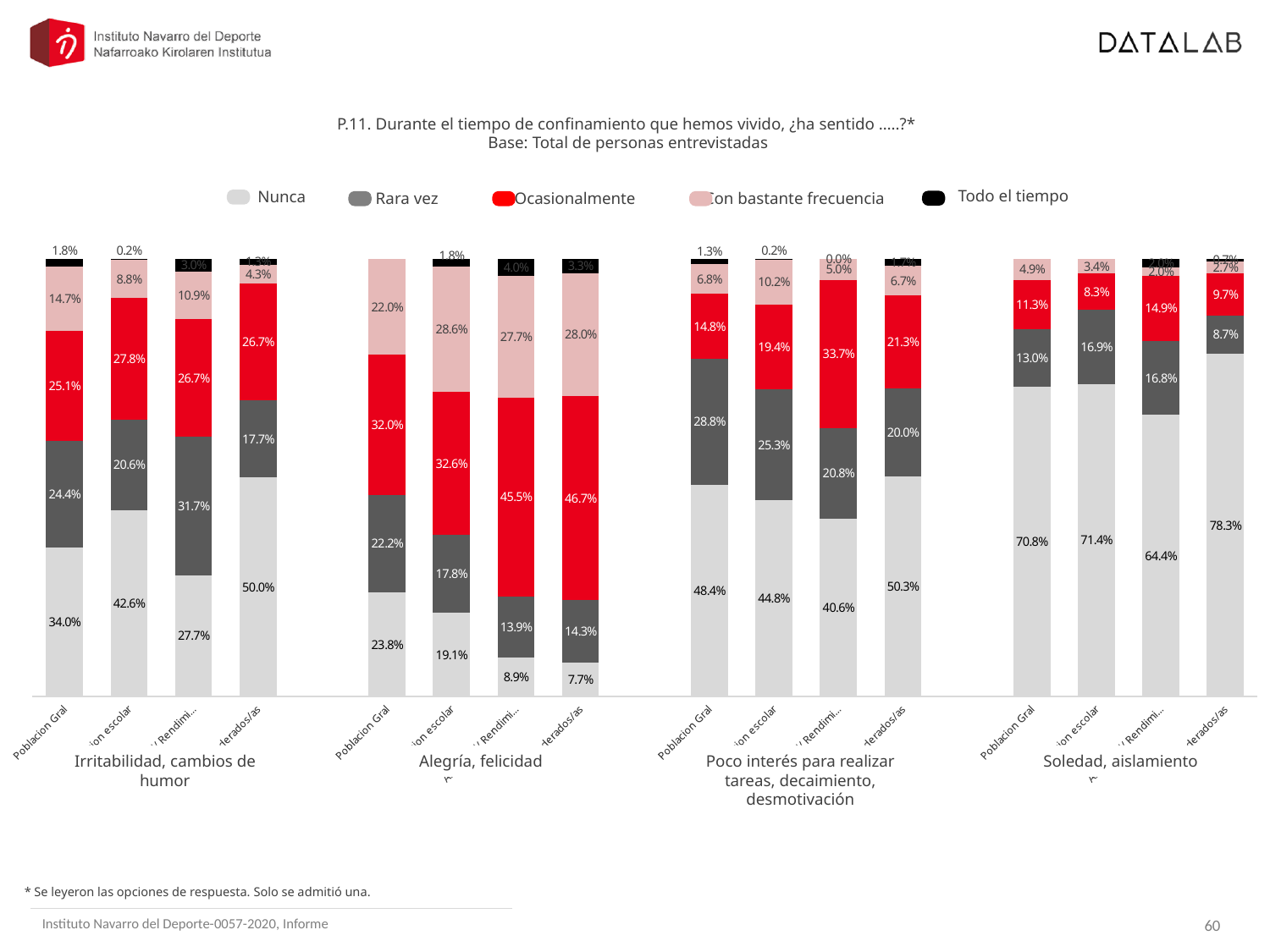
For Poblacion Gral, what is the difference between the Nunca value in 'Soledad, aislamiento' and the Nunca value in 'Irritabilidad, cambios de humor'? 36.8 percentage points Looking only at the Poblacion Gral bars, which group has the highest Nunca value? Soledad, aislamiento What kind of chart is shown on the slide? Stacked bar chart For Poblacion Gral, is the Rara vez value larger in 'Irritabilidad, cambios de humor' or in 'Poco interés para realizar tareas, decaimiento, desmotivación'? Poco interés para realizar tareas, decaimiento, desmotivación How many question groups (categories along the x axis) does the chart show? 4 For Poblacion Gral in the 'Alegría, felicidad' group, what is the value for Ocasionalmente? 32.0% How many series does the legend list? 5 For Poblacion Gral in the 'Soledad, aislamiento' group, what is the value for Nunca? 70.8% Looking only at the Poblacion Gral bars, which group has the lowest Nunca value? Alegría, felicidad For Poblacion Gral in the 'Poco interés para realizar tareas, decaimiento, desmotivación' group, what is the value for Con bastante frecuencia? 6.8% For Poblacion Gral in the 'Irritabilidad, cambios de humor' group, what is the value for Todo el tiempo? 1.8% For Poblacion Gral in the 'Irritabilidad, cambios de humor' group, what is the value for Nunca? 34.0%